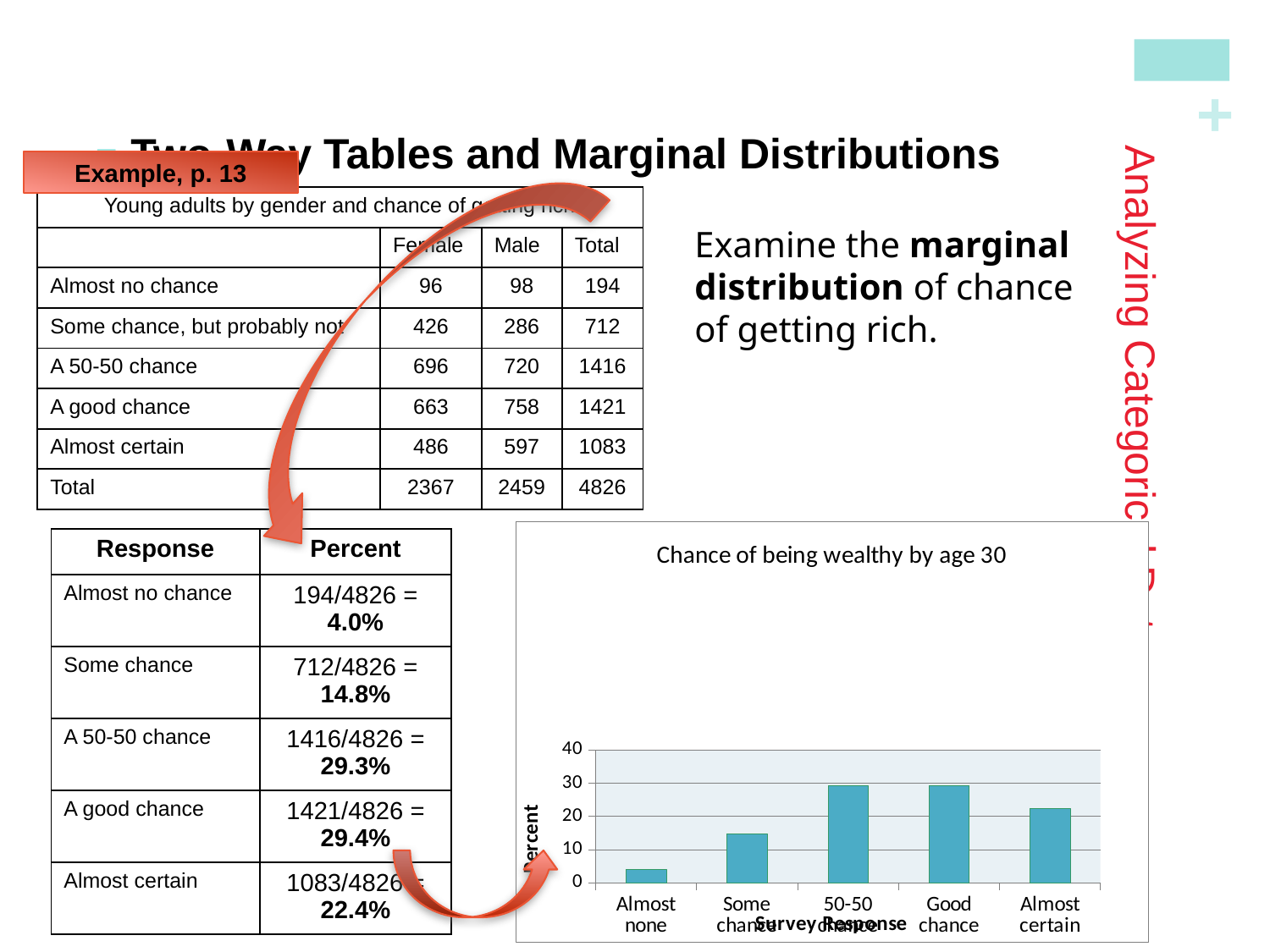
Do the values rise or fall from Almost none to 50-50 chance? rise What is the label on the y axis of the chart? Percent Which is larger, the value for Almost certain or the value for Some chance? Almost certain How many categories are shown on the x axis of the chart? 5 Is the value for Almost none greater or less than 10? less Is the value for 50-50 chance greater or less than 20? greater What kind of chart is shown on the slide? bar chart What is the title of the chart? Chance of being wealthy by age 30 Is the value for Almost certain greater or less than 20? greater Which category has the lowest bar in the chart? Almost none